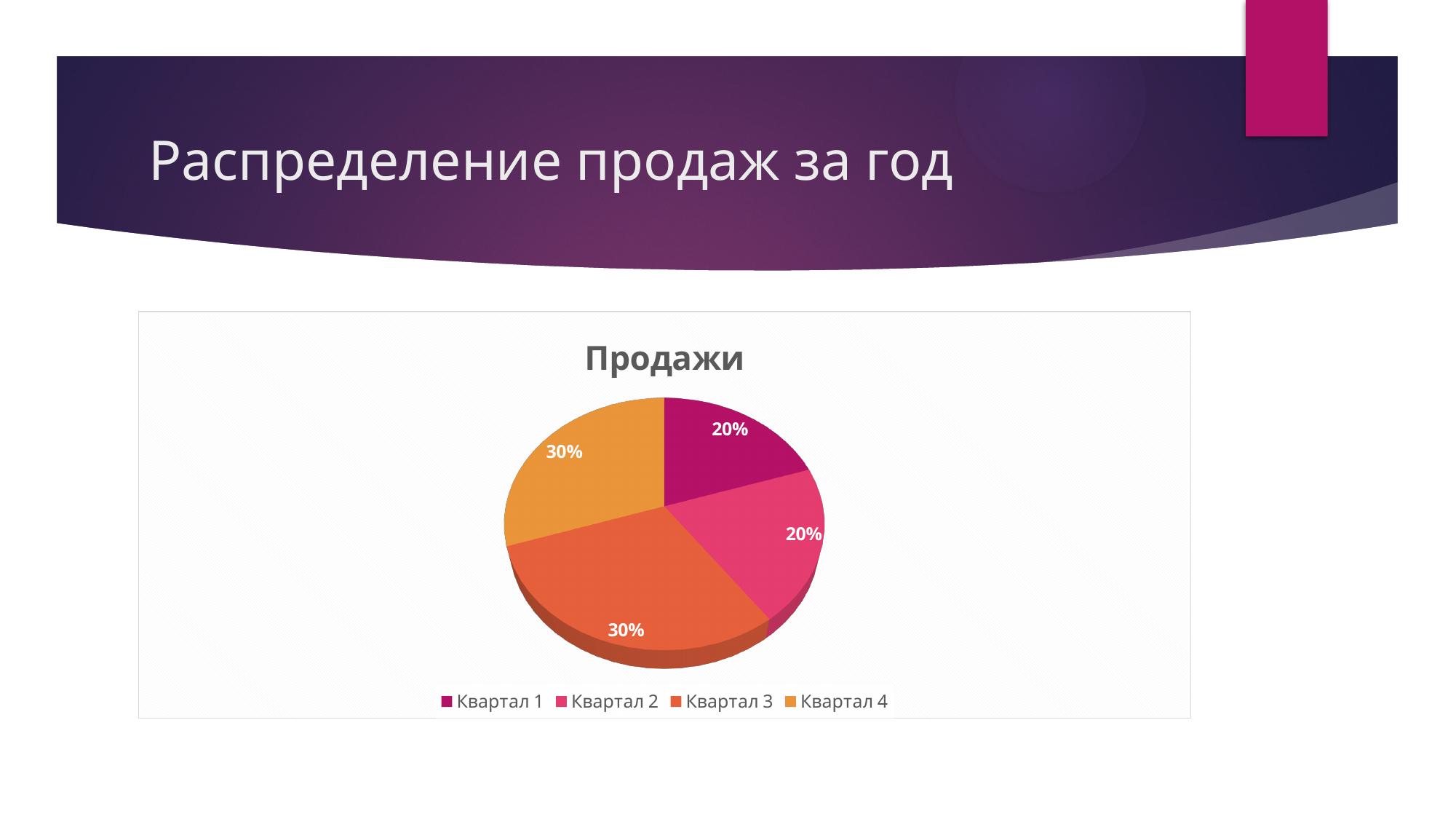
What colour is the slice for Квартал 4? orange Which is larger, the share for Квартал 2 or the share for Квартал 4? Квартал 4 What kind of chart is shown on the slide? pie chart What share of the pie does Квартал 1 have? 20% What share of the pie does Квартал 2 have? 20% What is the title of the chart? Продажи What share of the pie does Квартал 3 have? 30% What is the difference in percentage points between the share for Квартал 4 and the share for Квартал 2? 10 Which is larger, the share for Квартал 3 or the share for Квартал 1? Квартал 3 How many slices does the pie chart have? 4 How many entries does the legend list? 4